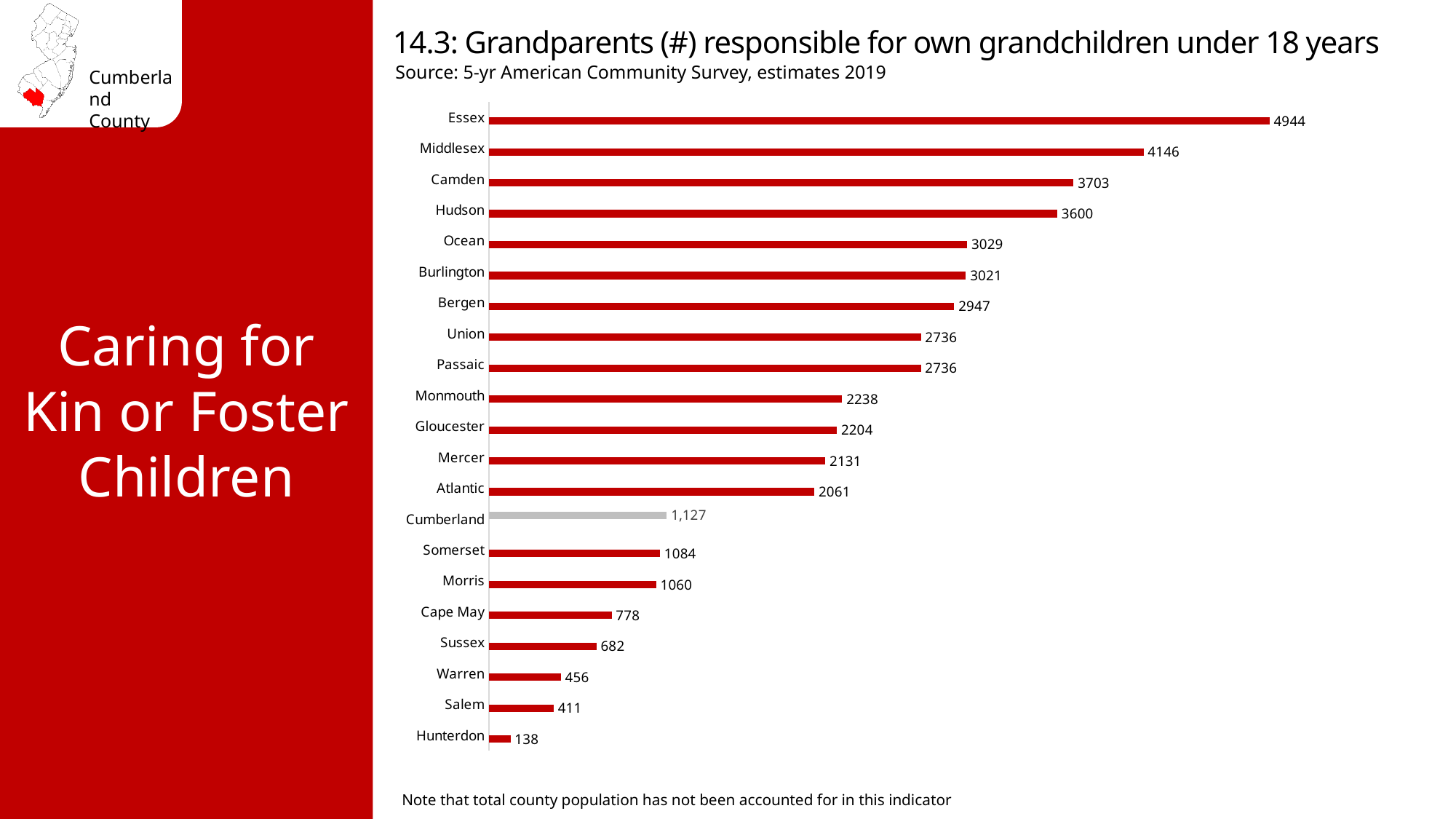
What is the difference between the values for Essex and Middlesex? 798 What is the value shown for Essex? 4944 Which county has the lowest value on the chart? Hunterdon What is the difference between the values for Somerset and Morris? 24 What kind of chart is shown on the slide? Bar chart Which has a larger value, Camden or Hudson? Camden What is the number of grandparents responsible for own grandchildren in Cumberland County? 1,127 What is the value shown for Cape May? 778 How many counties are shown on the chart? 21 Which county's bar is shown in grey rather than red? Cumberland Which county has the highest number of grandparents responsible for own grandchildren? Essex Which has a larger value, Warren or Salem? Warren